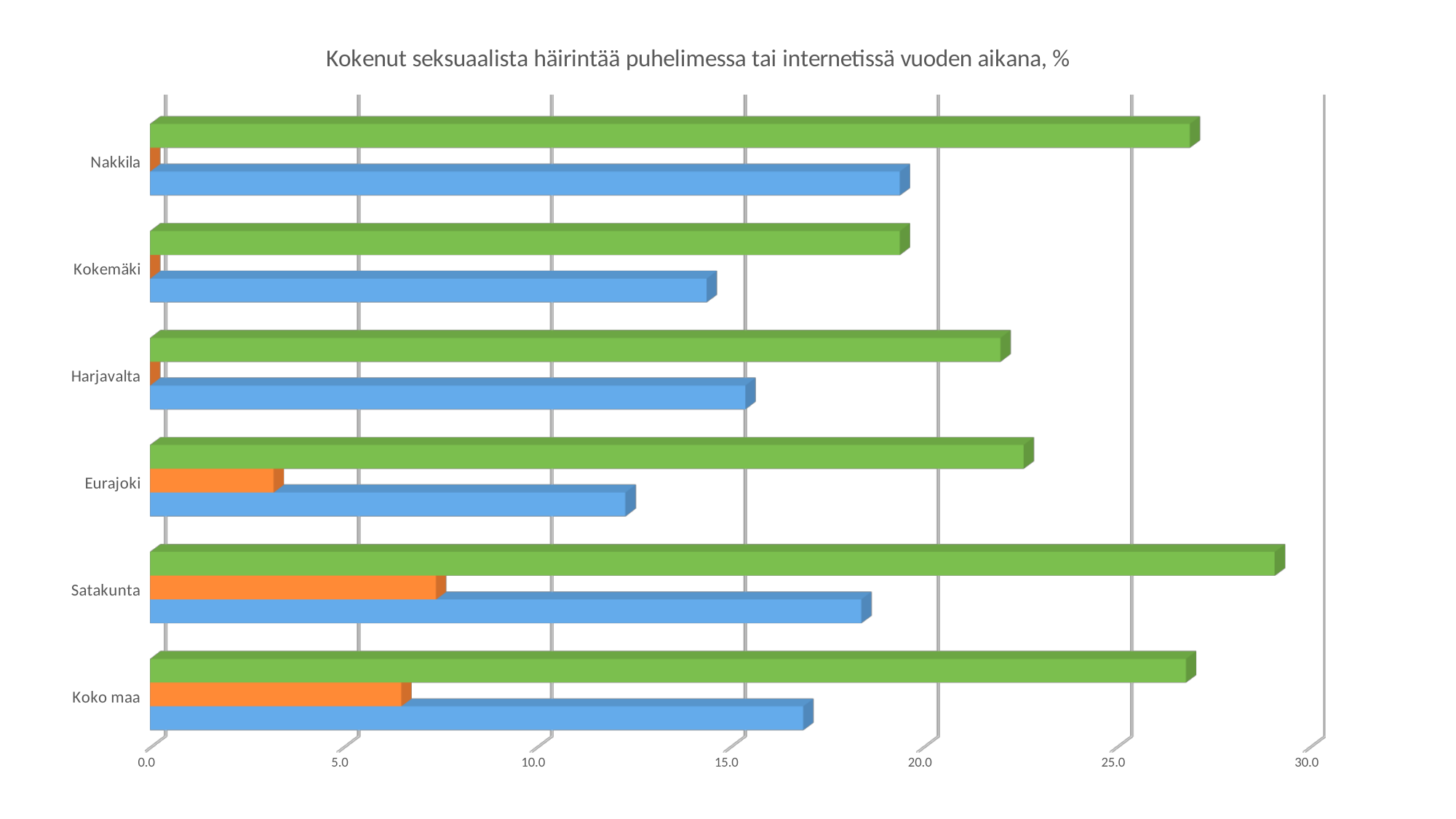
Which category has the longest orange bar? Satakunta What kind of chart is shown on the slide? bar chart Is the orange bar for Eurajoki greater or less than 5.0? less What is the title of the chart? Kokenut seksuaalista häirintää puhelimessa tai internetissä vuoden aikana, % Which category has the shortest green bar? Kokemäki How many categories (areas) are shown on the vertical axis? 6 How many bars are plotted for each category? 3 Which category has the shortest blue bar? Eurajoki Is the green bar for Satakunta greater or less than 25.0? greater Which is larger, the blue bar for Harjavalta or the blue bar for Eurajoki? Harjavalta Is the blue bar for Eurajoki greater or less than 15.0? less Which category has the longest green bar? Satakunta